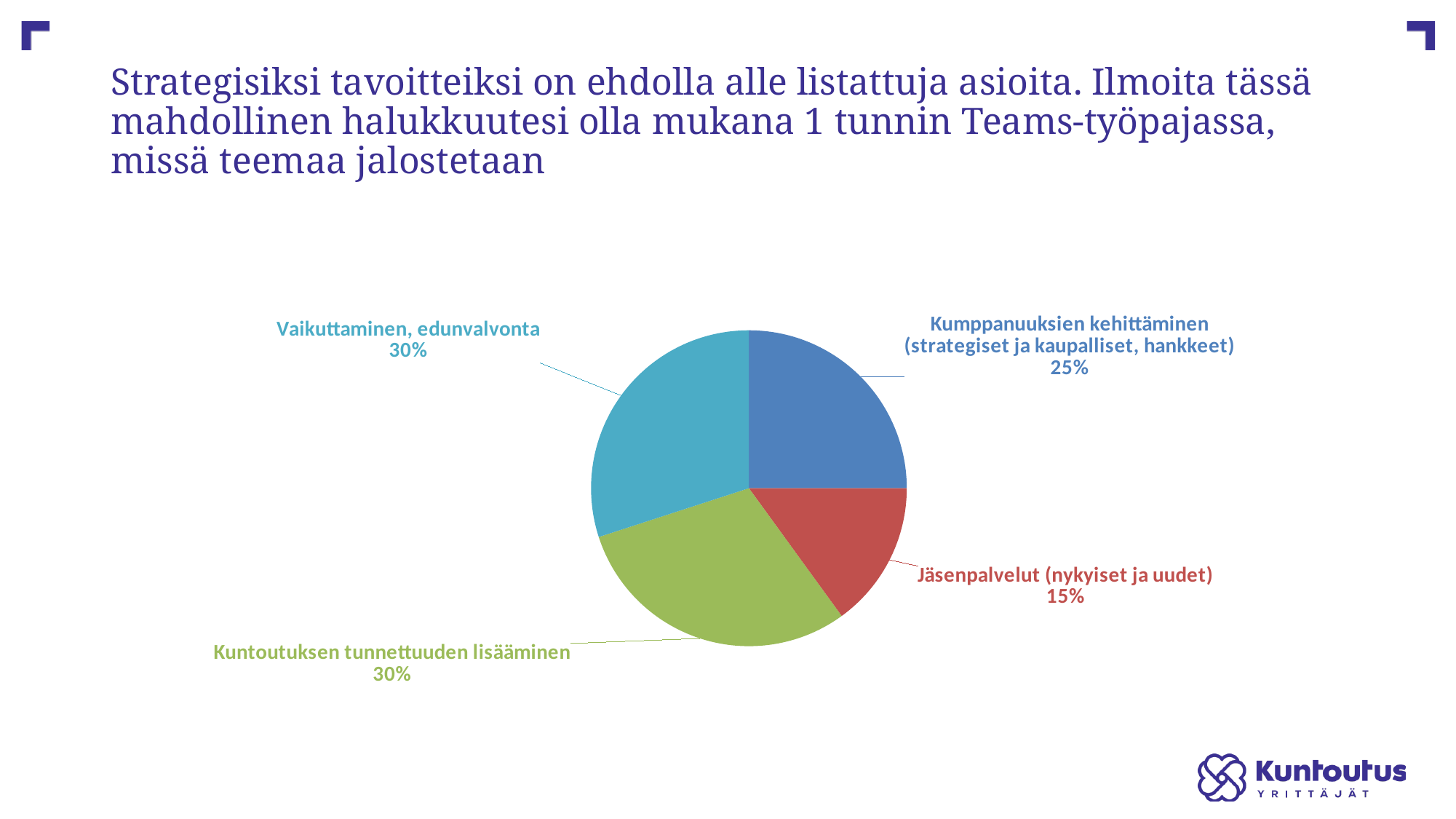
What is the value shown for "Kuntoutuksen tunnettuuden lisääminen"? 30% What colour is the slice for "Jäsenpalvelut (nykyiset ja uudet)"? red What share of the pie does "Kumppanuuksien kehittäminen (strategiset ja kaupalliset, hankkeet)" have? 25% How many slices does the pie chart have? 4 Which is larger: "Vaikuttaminen, edunvalvonta" or "Kumppanuuksien kehittäminen (strategiset ja kaupalliset, hankkeet)"? Vaikuttaminen, edunvalvonta What is the combined share of "Vaikuttaminen, edunvalvonta" and "Kuntoutuksen tunnettuuden lisääminen"? 60% What is the difference in percentage points between "Kumppanuuksien kehittäminen (strategiset ja kaupalliset, hankkeet)" and "Jäsenpalvelut (nykyiset ja uudet)"? 10 percentage points What kind of chart is shown on the slide? pie chart What is the value shown for "Vaikuttaminen, edunvalvonta"? 30% What share of the pie does "Jäsenpalvelut (nykyiset ja uudet)" have? 15% Which slice of the pie chart is the smallest? Jäsenpalvelut (nykyiset ja uudet) Which is larger: "Kumppanuuksien kehittäminen (strategiset ja kaupalliset, hankkeet)" or "Jäsenpalvelut (nykyiset ja uudet)"? Kumppanuuksien kehittäminen (strategiset ja kaupalliset, hankkeet)